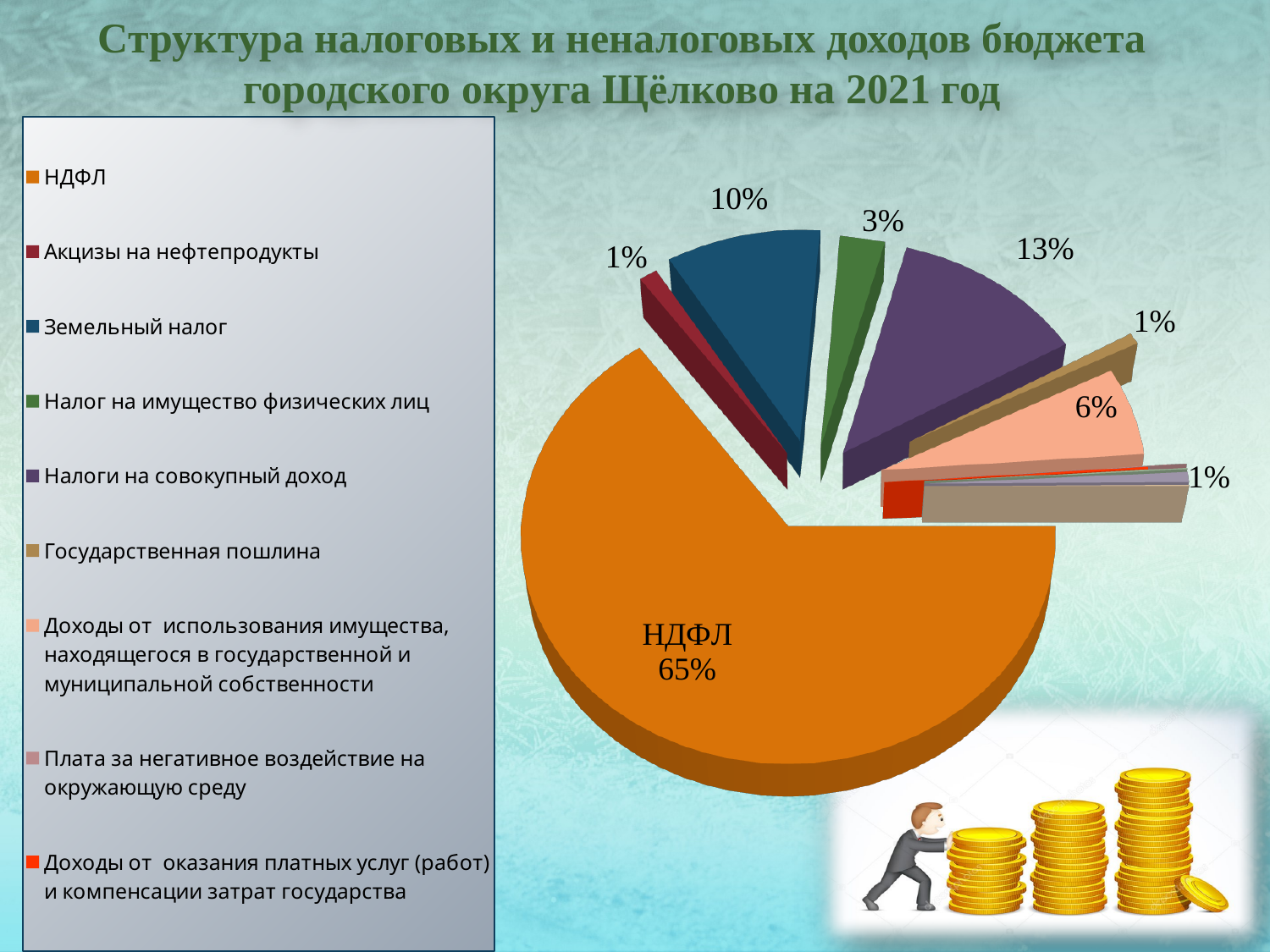
What kind of chart is shown on the slide? pie chart What share of the pie does НДФЛ account for? 65% What is the value shown for Акцизы на нефтепродукты? 1% What is the value shown for Земельный налог? 10% Which category has the largest share of the pie? НДФЛ How many entries does the legend list? 9 What is the value shown for Налоги на совокупный доход? 13% What is the value shown for Налог на имущество физических лиц? 3% What is the difference between the shares of Налоги на совокупный доход and Земельный налог? 3% What colour is the НДФЛ slice? orange What is the value shown for Доходы от использования имущества, находящегося в государственной и муниципальной собственности? 6% Which is larger: the share of Земельный налог or the share of Доходы от использования имущества? Земельный налог